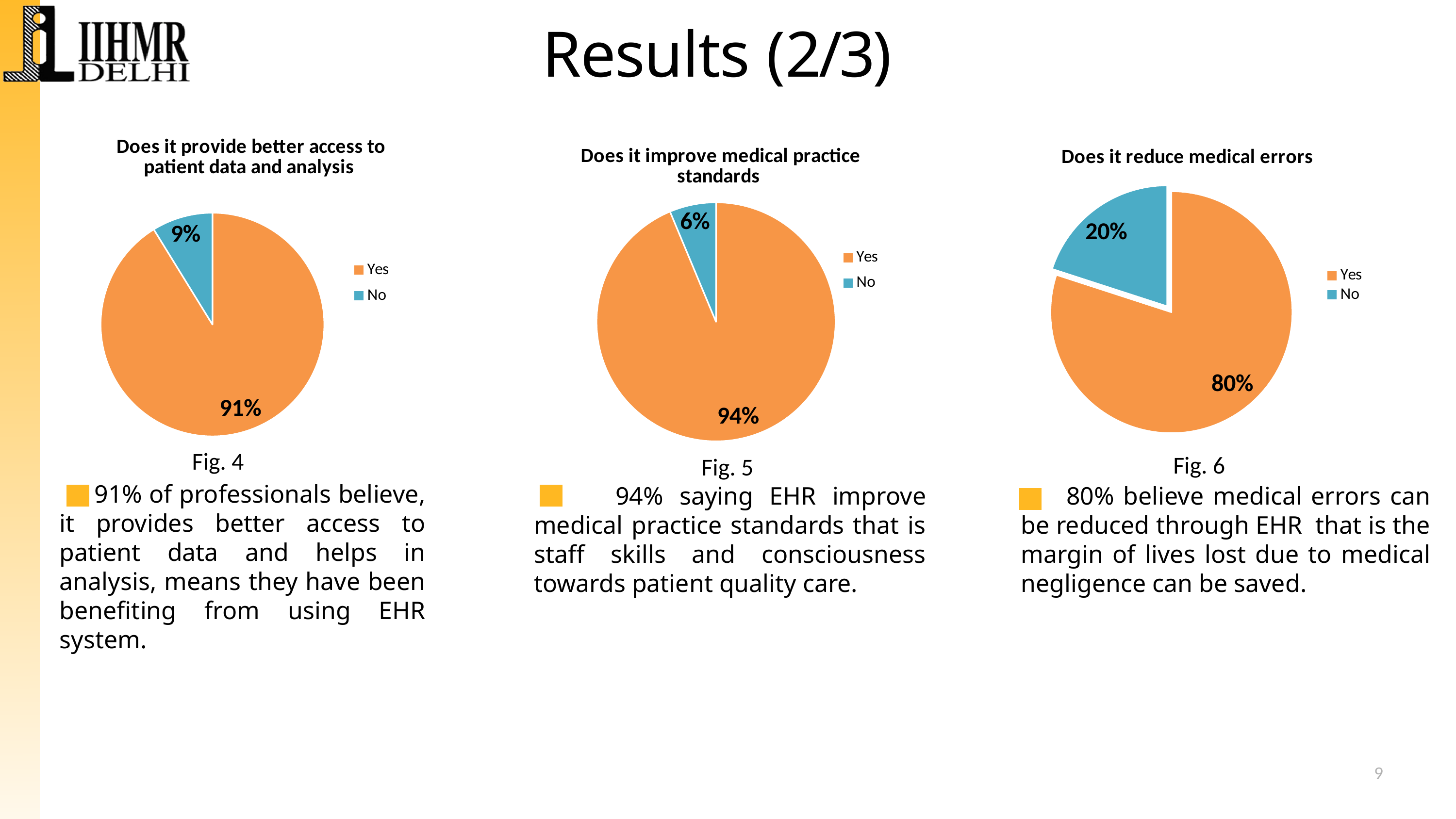
In the chart titled 'Does it provide better access to patient data and analysis', what share of the pie is 'No'? 9% In the chart titled 'Does it reduce medical errors', what colour is the 'No' slice? Blue How many slices does the chart titled 'Does it improve medical practice standards' have? 2 In the chart titled 'Does it reduce medical errors', what share of the pie is 'Yes'? 80% In the chart titled 'Does it improve medical practice standards', which slice is the smallest? No In the chart titled 'Does it improve medical practice standards', what share of the pie is 'Yes'? 94% What kind of chart is the chart titled 'Does it provide better access to patient data and analysis'? Pie chart In the chart titled 'Does it reduce medical errors', which slice is the largest? Yes In the chart titled 'Does it reduce medical errors', what is the difference between the 'Yes' and 'No' shares? 60%